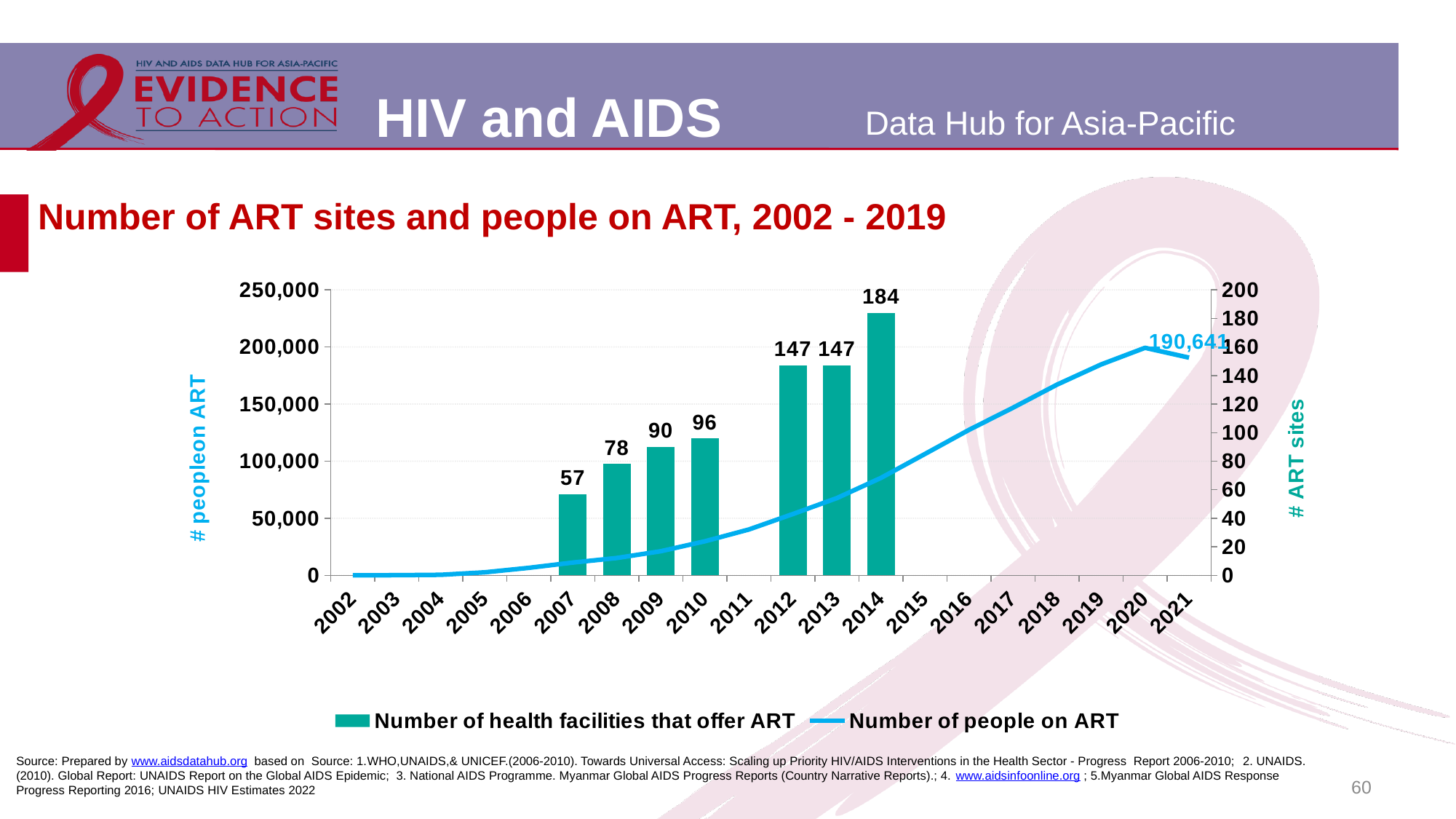
How many series does the legend list? 2 What is the number of health facilities that offer ART in 2014? 184 Is the number of people on ART in 2017 greater or less than 100,000? greater Which year has more health facilities that offer ART, 2008 or 2010? 2010 What is the number of health facilities that offer ART in 2007? 57 What is the overall trend of the number of people on ART from 2002 to 2020? rising What is the difference in the number of health facilities that offer ART between 2009 and 2008? 12 Among the years with a bar shown, which year has the lowest number of health facilities that offer ART? 2007 What is the number of health facilities that offer ART in 2010? 96 Which year has the highest number of health facilities that offer ART? 2014 What is the difference in the number of health facilities that offer ART between 2014 and 2013? 37